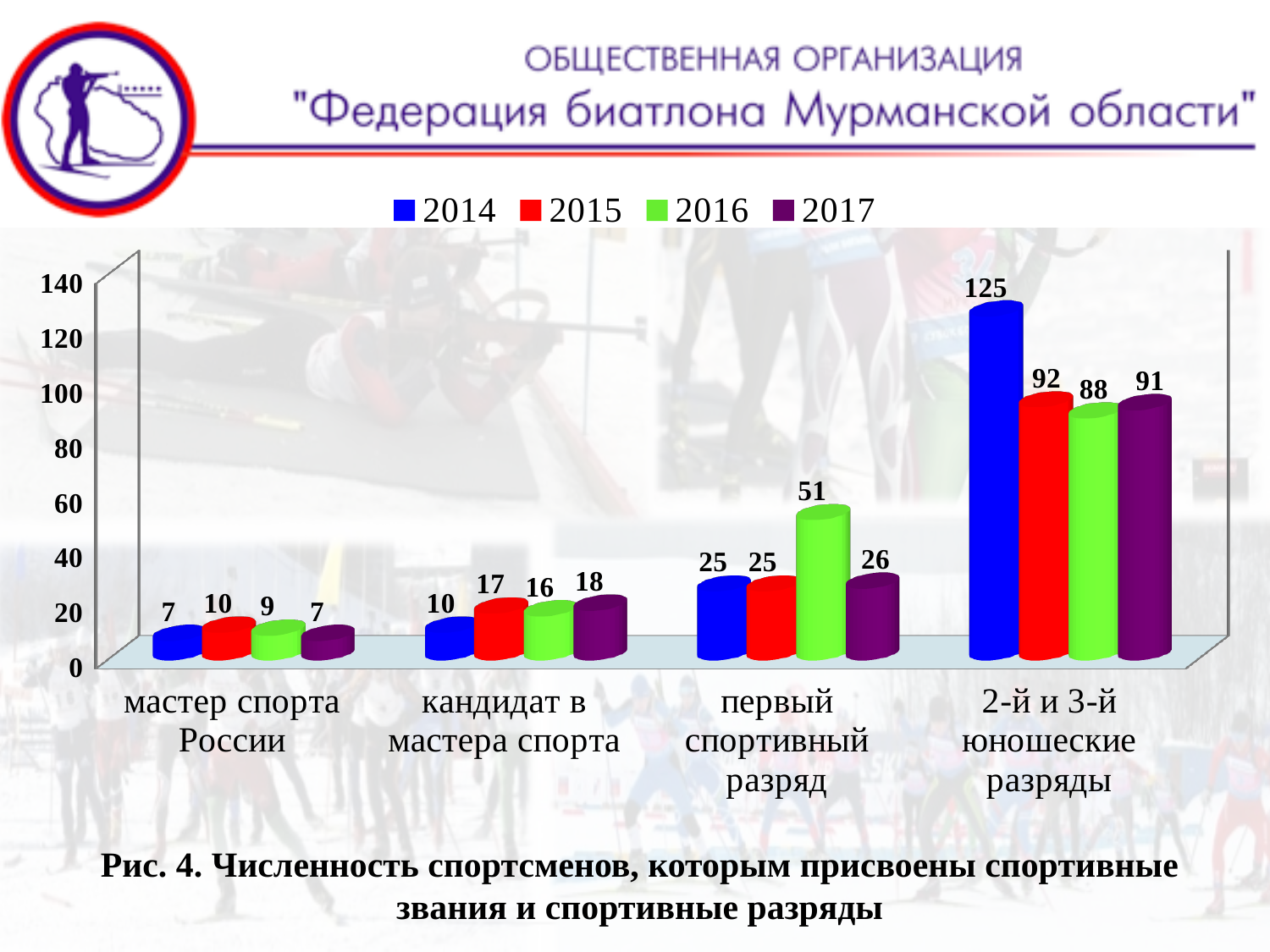
What kind of chart is shown on the slide? bar chart Which is larger in the category "первый спортивный разряд": the value for 2016 or the value for 2017? 2016 How many series does the legend list? 4 Which colour represents the year 2017 in the legend? purple What is the value for 2016 in the category "первый спортивный разряд"? 51 What is the value for 2017 in the category "кандидат в мастера спорта"? 18 What is the value for 2014 in the category "2-й и 3-й юношеские разряды"? 125 Which year has the highest value in the category "2-й и 3-й юношеские разряды"? 2014 How many categories are shown on the x axis? 4 Is the value for 2015 in the category "2-й и 3-й юношеские разряды" greater or less than 100? less Which year has the lowest value in the category "кандидат в мастера спорта"? 2014 What is the difference between the 2014 and 2015 values in the category "2-й и 3-й юношеские разряды"? 33